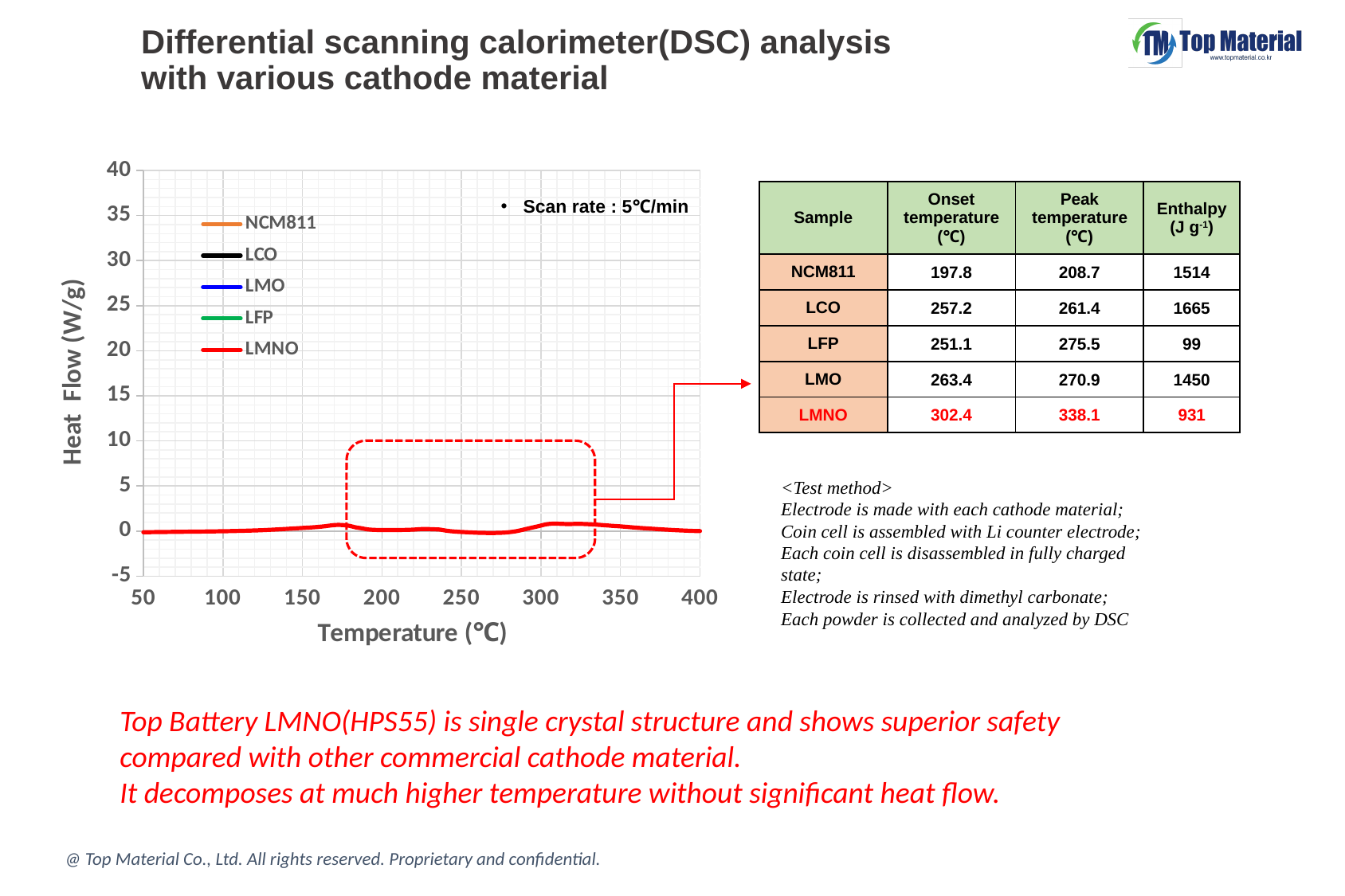
Is the LMNO heat flow at 200 ℃ greater or less than 10 W/g? less Is the LMNO heat flow at 300 ℃ greater or less than 5 W/g? less Does the LMNO heat flow curve ever rise above 10 W/g between 50 and 400 ℃? No Which series in the legend is drawn in red? LMNO How many series does the chart legend list? 5 What is the title of the x axis of the chart? Temperature (℃) What kind of chart is shown on the slide? line chart